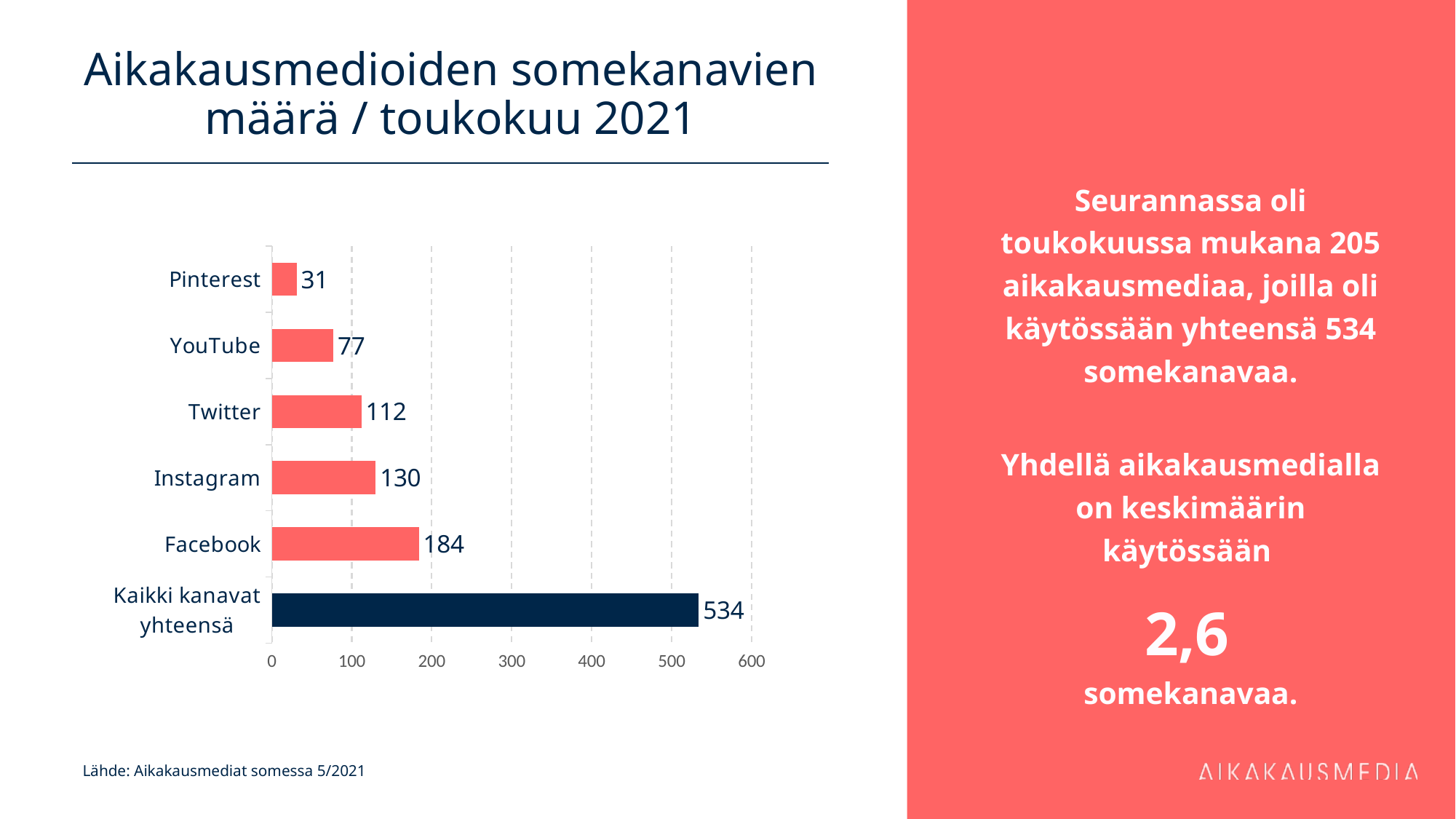
What is the value for Pinterest? 31 Which category has the lowest value? Pinterest What is the difference between the values for Facebook and Instagram? 54 Which is larger, the value for Twitter or the value for YouTube? Twitter What is the title of the chart on the slide? Aikakausmedioiden somekanavien määrä / toukokuu 2021 Which individual social media channel has the highest number? Facebook What is the value for Kaikki kanavat yhteensä? 534 What kind of chart is shown on the slide? Bar chart What is the difference between the values for Twitter and YouTube? 35 How many categories are shown in the chart? 6 What is the value for Instagram? 130 What is the value for Facebook? 184